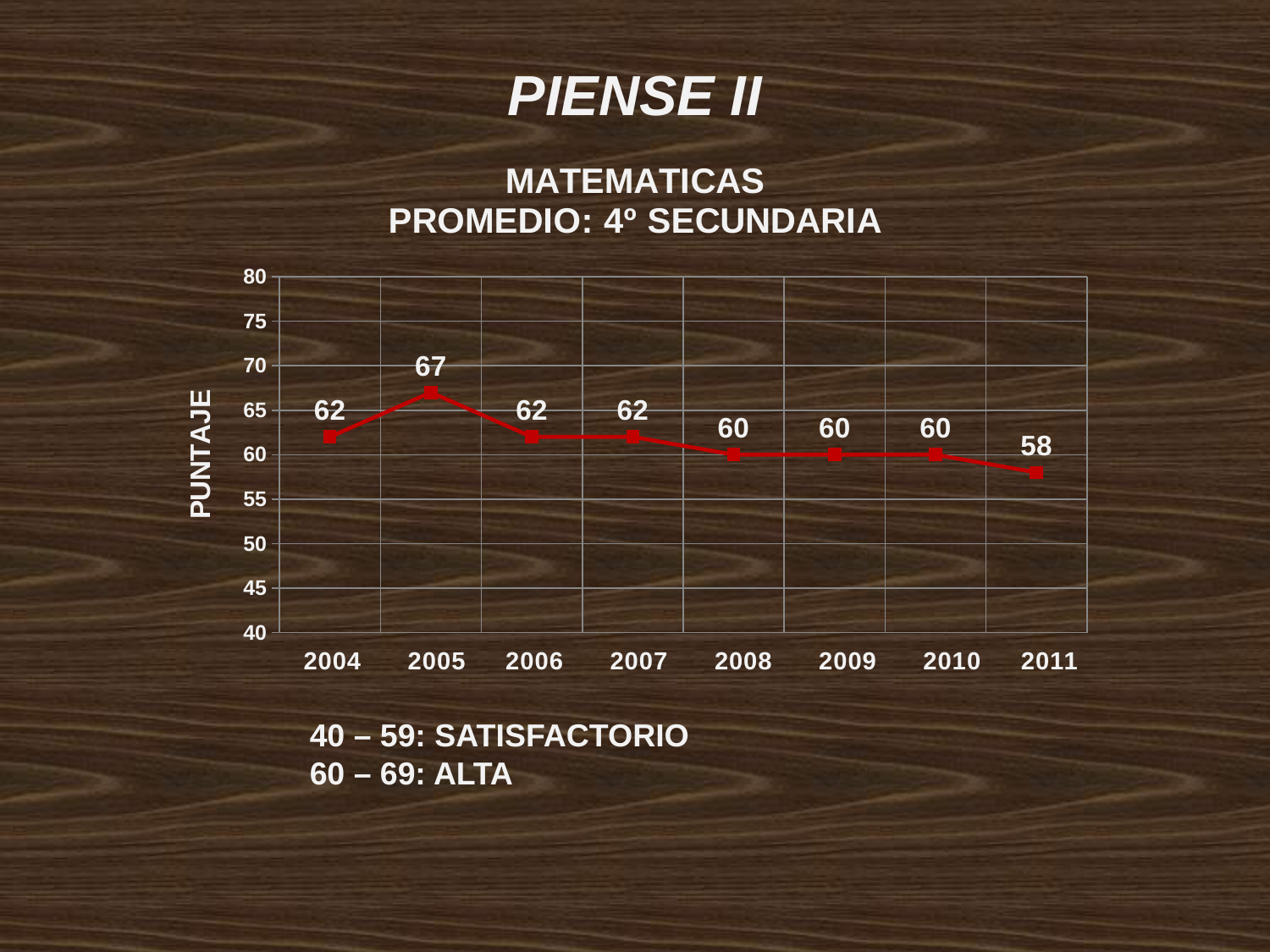
What is the difference between the values for 2004 and 2005? 5 What is the value for 2005? 67 Which year has the highest value? 2005 What is the difference between the values for 2005 and 2011? 9 Is the value for 2005 greater or less than 65? greater What is the value for 2011? 58 What kind of chart is shown? line chart Which is larger, the value for 2007 or the value for 2009? 2007 What is the label on the vertical axis? PUNTAJE How many years are plotted on the x axis? 8 What is the value for 2008? 60 Which year has the lowest value? 2011